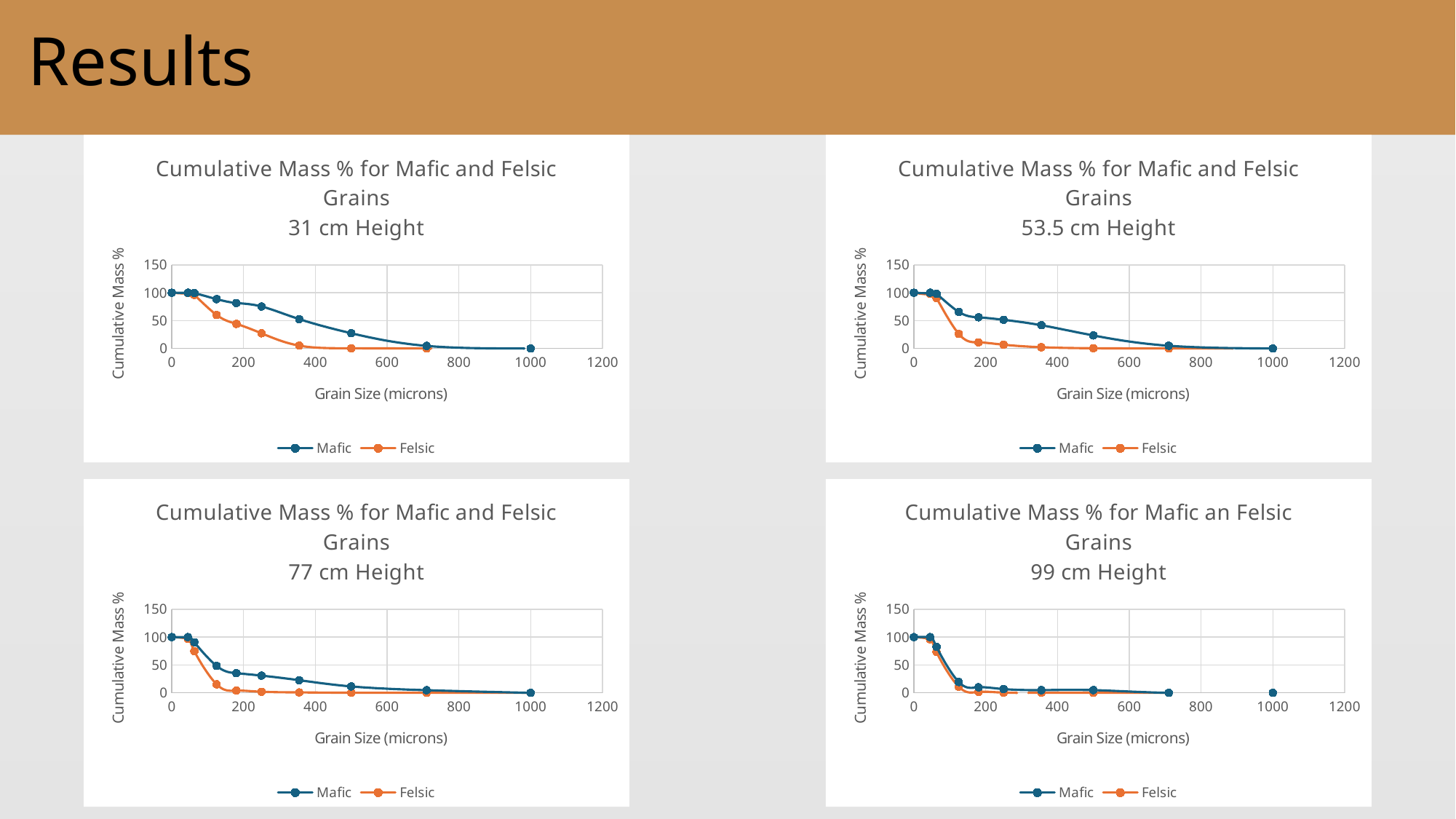
What is the x-axis label on the '77 cm Height' chart? Grain Size (microns) On the '99 cm Height' chart, is the Mafic value at 200 microns greater or less than 50? less On the '31 cm Height' chart, is the Mafic value at 200 microns greater or less than 50? greater On the '31 cm Height' chart, is the Mafic value at 500 microns greater or less than 50? less On the '31 cm Height' chart, which series has the larger value at 400 microns, Mafic or Felsic? Mafic On the '53.5 cm Height' chart, which series has the larger value at 200 microns, Mafic or Felsic? Mafic What kind of chart is the '31 cm Height' chart at the top left? line chart How many series does the legend list on the '53.5 cm Height' chart? 2 On the '31 cm Height' chart, do the Mafic values rise or fall as grain size increases? fall Which series is drawn in orange on the '99 cm Height' chart? Felsic